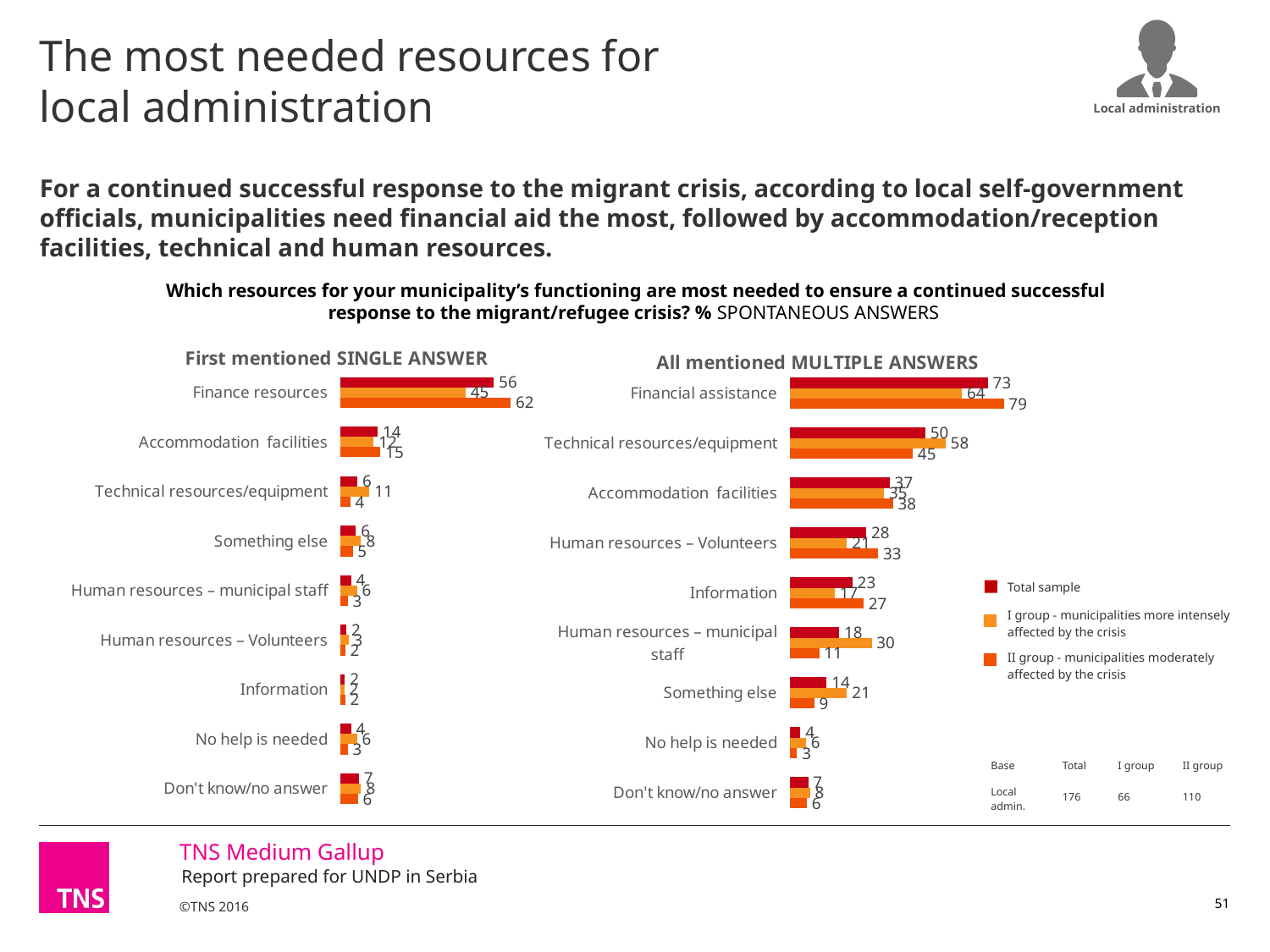
How many categories are shown in the 'All mentioned MULTIPLE ANSWERS' chart? 9 In the 'All mentioned MULTIPLE ANSWERS' chart, which is larger for Human resources – municipal staff: the I group value or the II group value? I group What type of chart is the 'First mentioned SINGLE ANSWER' chart? Bar chart How many series does the legend list? 3 In the 'All mentioned MULTIPLE ANSWERS' chart, what is the difference between the II group and I group values for Financial assistance? 15 In the 'First mentioned SINGLE ANSWER' chart, what is the Total sample value for Finance resources? 56 In the 'First mentioned SINGLE ANSWER' chart, what is the difference between the II group and I group values for Finance resources? 17 In the 'All mentioned MULTIPLE ANSWERS' chart, what is the I group value for Technical resources/equipment? 58 In the 'All mentioned MULTIPLE ANSWERS' chart, what is the II group value for Financial assistance? 79 In the 'First mentioned SINGLE ANSWER' chart, which category has the highest Total sample value? Finance resources In the 'All mentioned MULTIPLE ANSWERS' chart, what is the Total sample value for Human resources – Volunteers? 28 In the 'All mentioned MULTIPLE ANSWERS' chart, which category has the lowest Total sample value? No help is needed